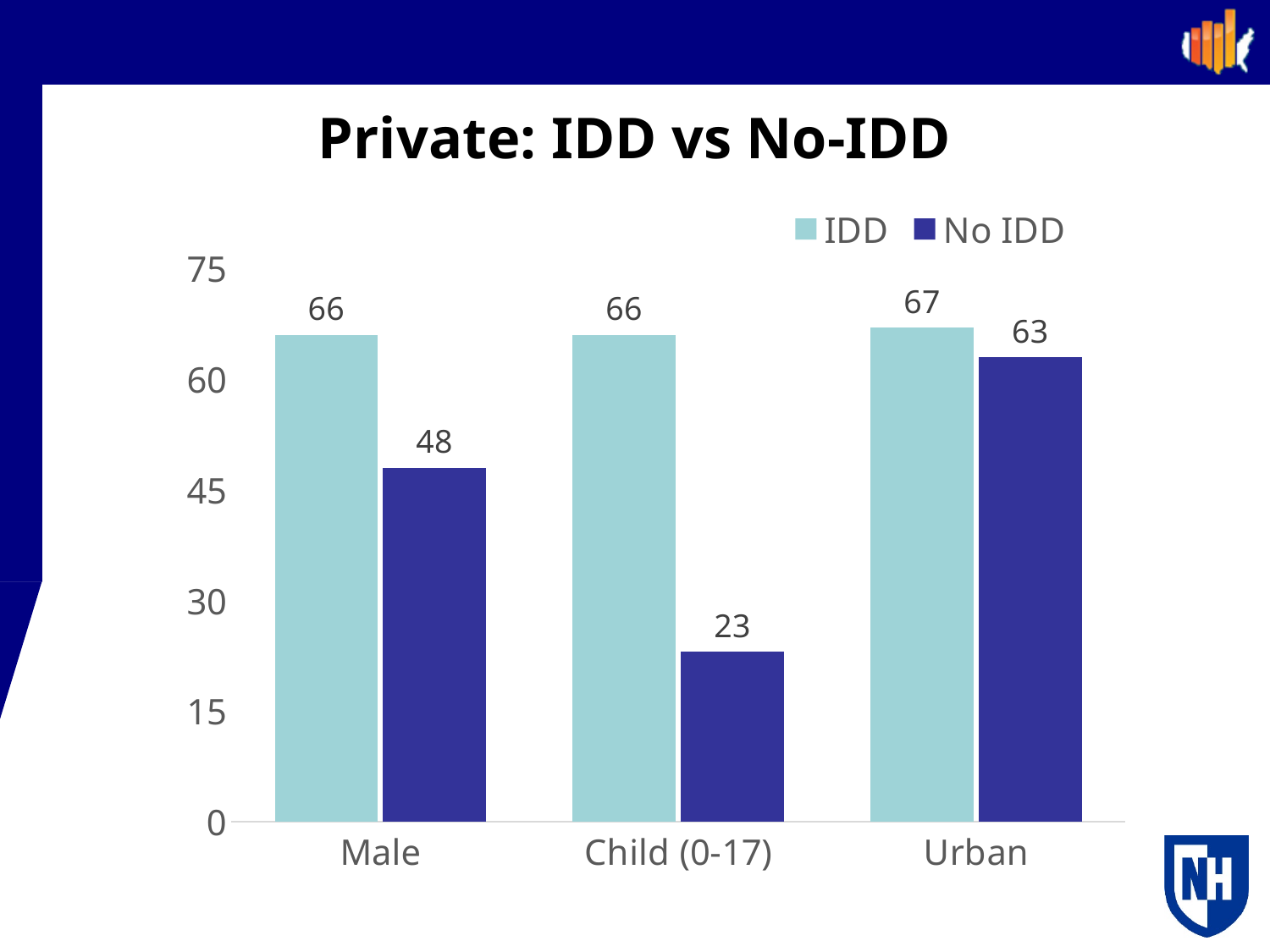
Which is larger for Urban, the IDD value or the No IDD value? IDD How many series does the legend list? 2 What is the difference between the IDD and No IDD values for Male? 18 What kind of chart is shown on the slide? bar chart Which category has the highest IDD value? Urban Is the No IDD value for Male greater or less than 45? greater What is the No IDD value for Child (0-17)? 23 What is the No IDD value for Urban? 63 What is the IDD value for Male? 66 How many categories are shown on the x axis? 3 Which category has the lowest No IDD value? Child (0-17) What is the difference between the IDD and No IDD values for Child (0-17)? 43